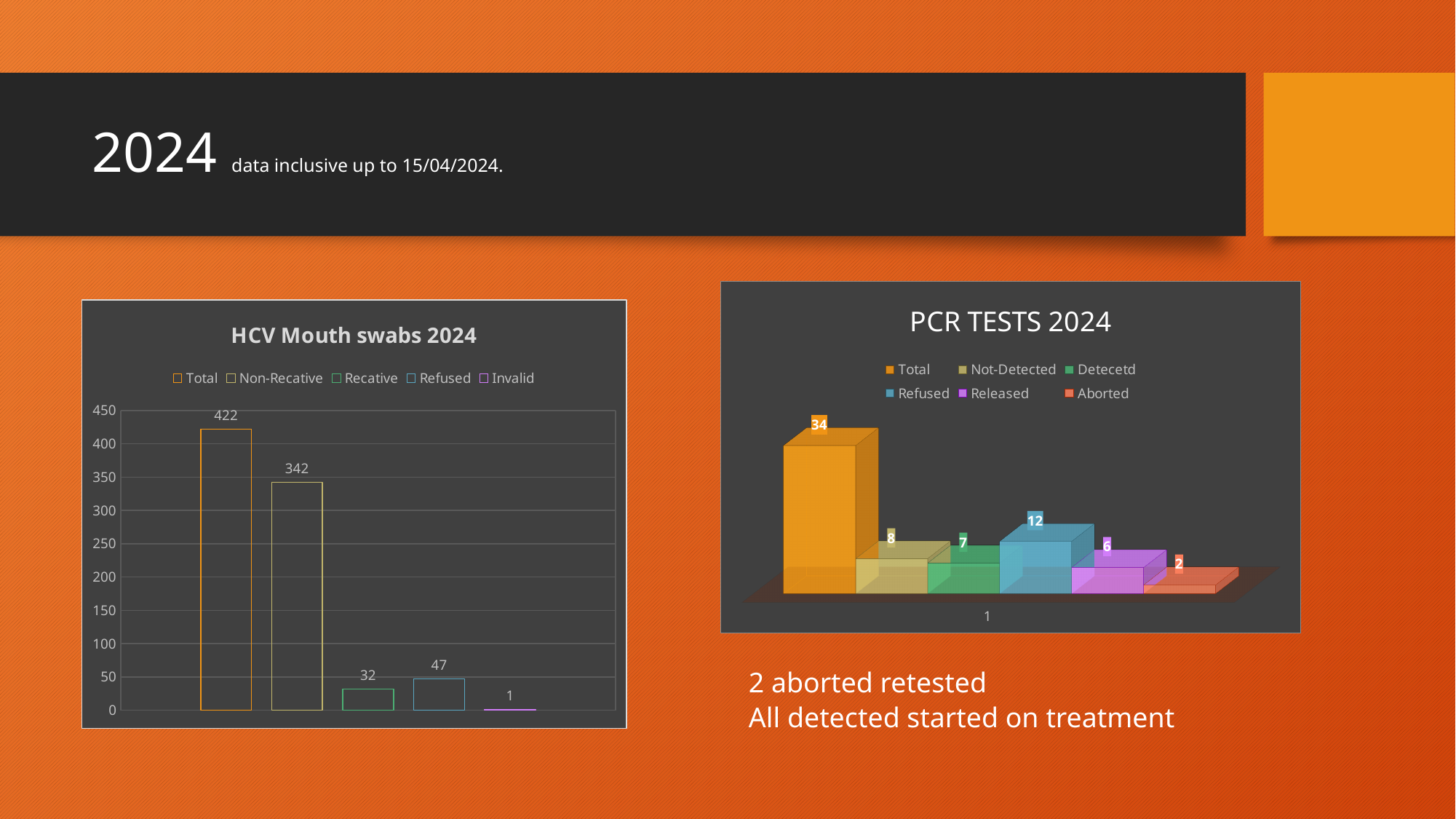
In the HCV Mouth swabs 2024 chart, which is larger, Recative or Refused? Refused In the PCR TESTS 2024 chart, what is the difference between Not-Detected and Detecetd? 1 In the HCV Mouth swabs 2024 chart, what is the difference between Total and Non-Recative? 80 In the PCR TESTS 2024 chart, which series has the lowest value? Aborted In the HCV Mouth swabs 2024 chart, what is the value for Total? 422 In the PCR TESTS 2024 chart, what is the value for Refused? 12 In the HCV Mouth swabs 2024 chart, what is the value for Non-Recative? 342 In the PCR TESTS 2024 chart, what is the value for Total? 34 In the HCV Mouth swabs 2024 chart, which series has the lowest value? Invalid What kind of chart is the PCR TESTS 2024 chart? Bar chart In the HCV Mouth swabs 2024 chart, what is the value for Refused? 47 How many series does the legend of the HCV Mouth swabs 2024 chart list? 5